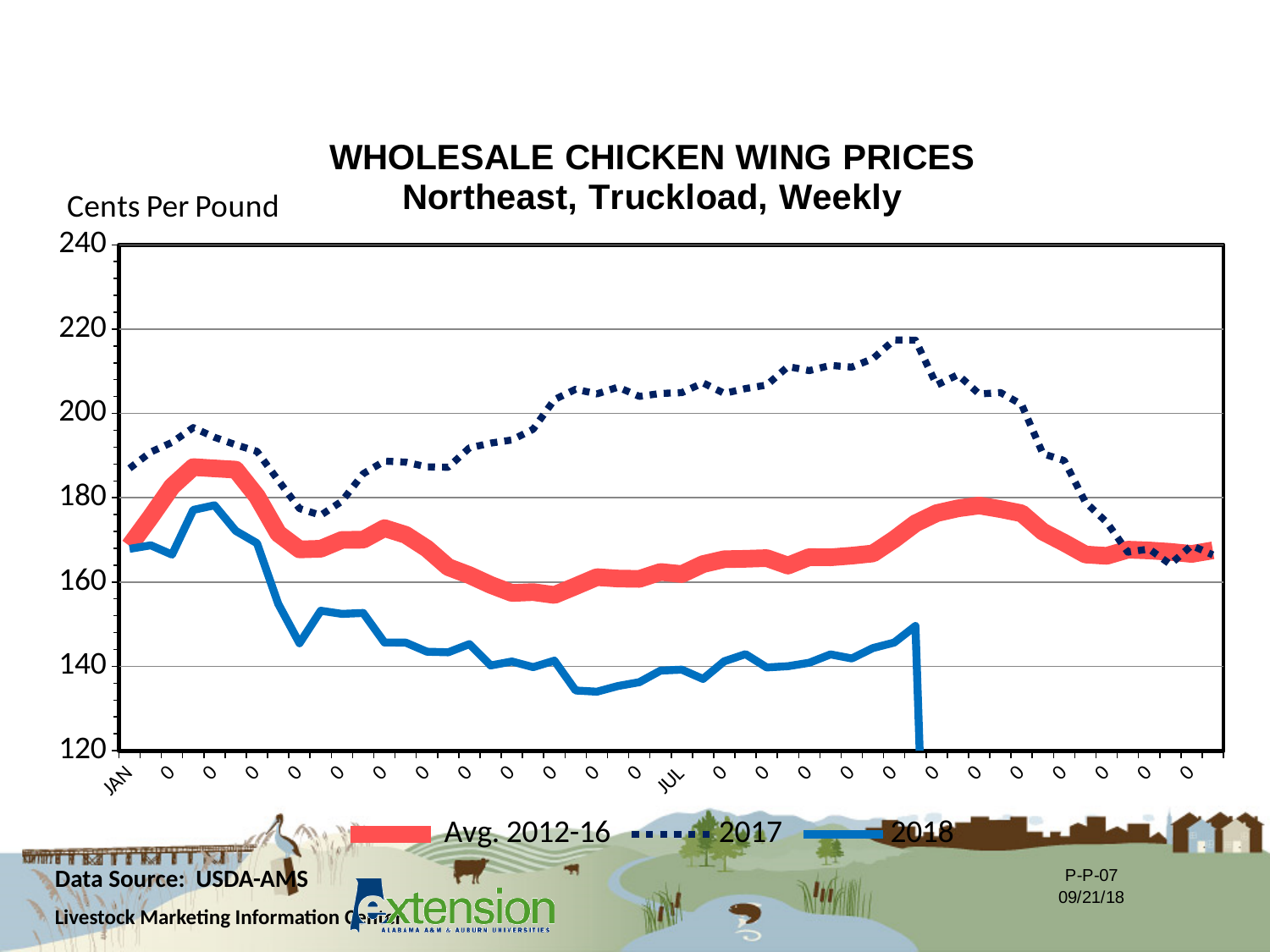
Which series has the highest value at JUL? 2017 How many series does the legend list? 3 At JUL, which series has the higher value: 2017 or 2018? 2017 Is the peak value of the 2017 series greater or less than 200? greater What kind of chart is shown on the slide? line chart Is the value of the 2018 series at JUL greater or less than 160? less Is the value of the Avg. 2012-16 series at JAN greater or less than 160? greater What unit is shown on the vertical axis of the chart? Cents Per Pound At JUL, which series has the higher value: Avg. 2012-16 or 2018? Avg. 2012-16 What are the three series listed in the legend? Avg. 2012-16, 2017, 2018 Does the 2018 series generally rise or fall from JAN to JUL? fall